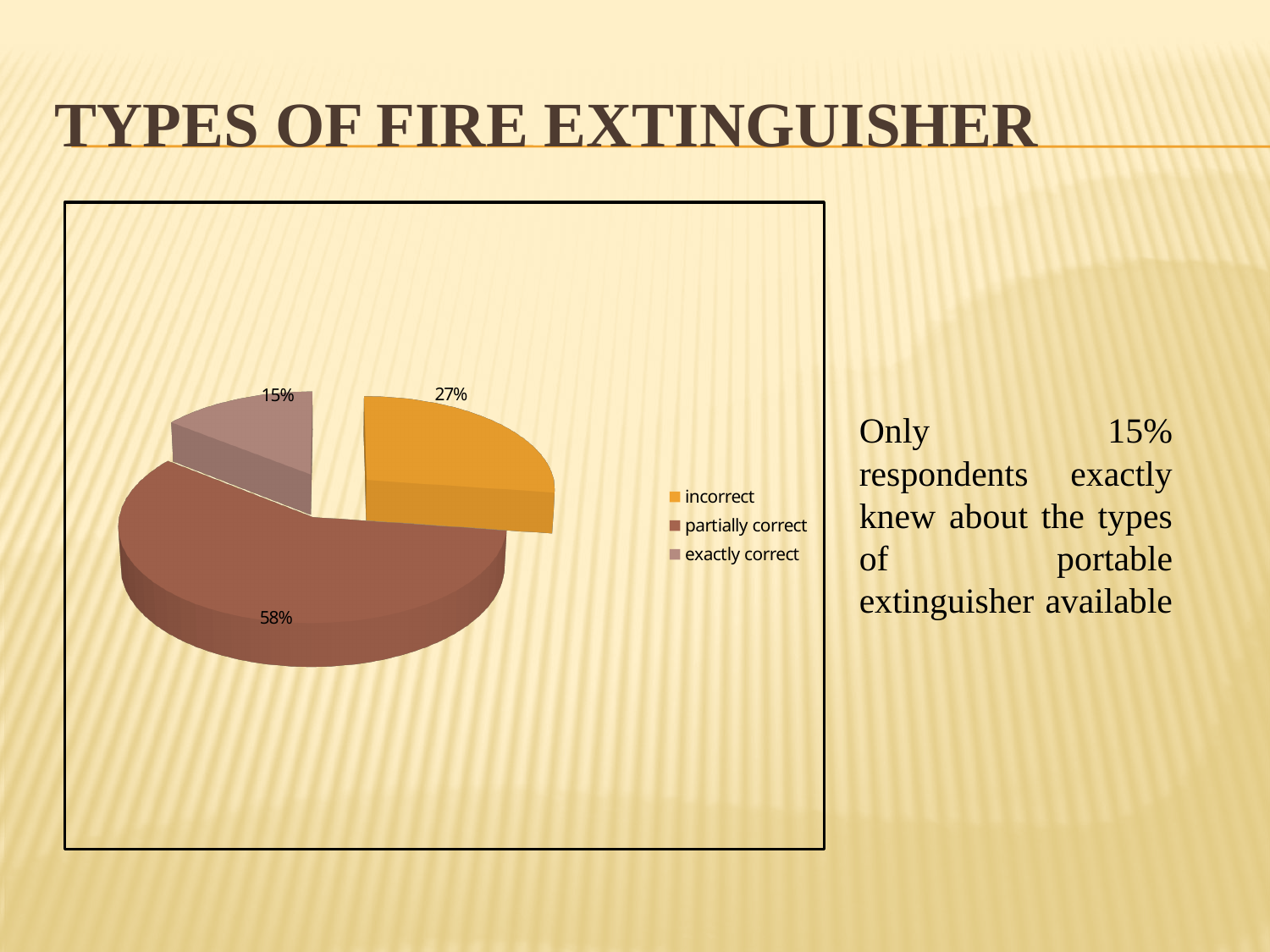
What kind of chart is shown on the slide? pie chart What is the difference in percentage points between the partially correct and incorrect slices? 31 What percentage of respondents were exactly correct? 15% Which is larger, the incorrect slice or the exactly correct slice? incorrect What percentage of respondents were partially correct? 58% What colour is the partially correct slice? brown How many entries does the legend list? 3 What is the difference in percentage points between the incorrect and exactly correct slices? 12 Which category has the smallest share of the pie? exactly correct What percentage of respondents were incorrect? 27% How many slices does the pie chart have? 3 Which category has the largest share of the pie? partially correct